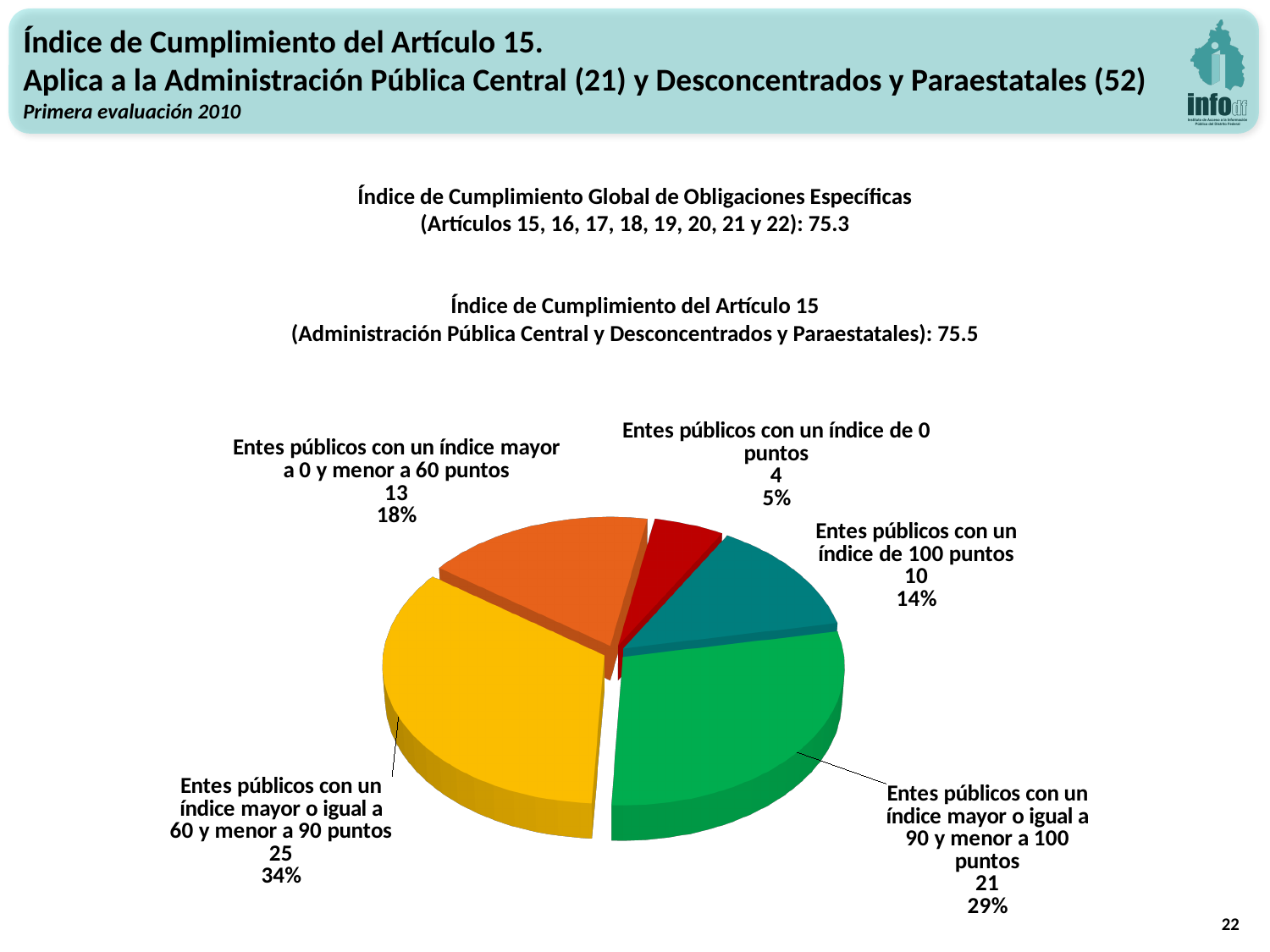
What percentage of the pie corresponds to entities with an index of 100 points? 14% What is the difference in the number of entities between the 60–90 points category and the 90–100 points category? 4 What kind of chart is shown on the slide? pie chart How many slices does the pie chart have? 5 What is the total number of entities across all slices of the pie? 73 How many public entities have an index greater than or equal to 60 and less than 90 points? 25 Which category has the smallest slice of the pie? Entes públicos con un índice de 0 puntos How many public entities have an index of 0 points (Entes públicos con un índice de 0 puntos)? 4 Which has more entities: the category with an index of 100 points or the category with an index greater than 0 and less than 60 points? Entes públicos con un índice mayor a 0 y menor a 60 puntos Which category has the largest slice of the pie? Entes públicos con un índice mayor o igual a 60 y menor a 90 puntos What colour is the slice for entities with an index greater than or equal to 90 and less than 100 points? green What share of the pie is the slice for entities with an index greater than 0 and less than 60 points? 18%